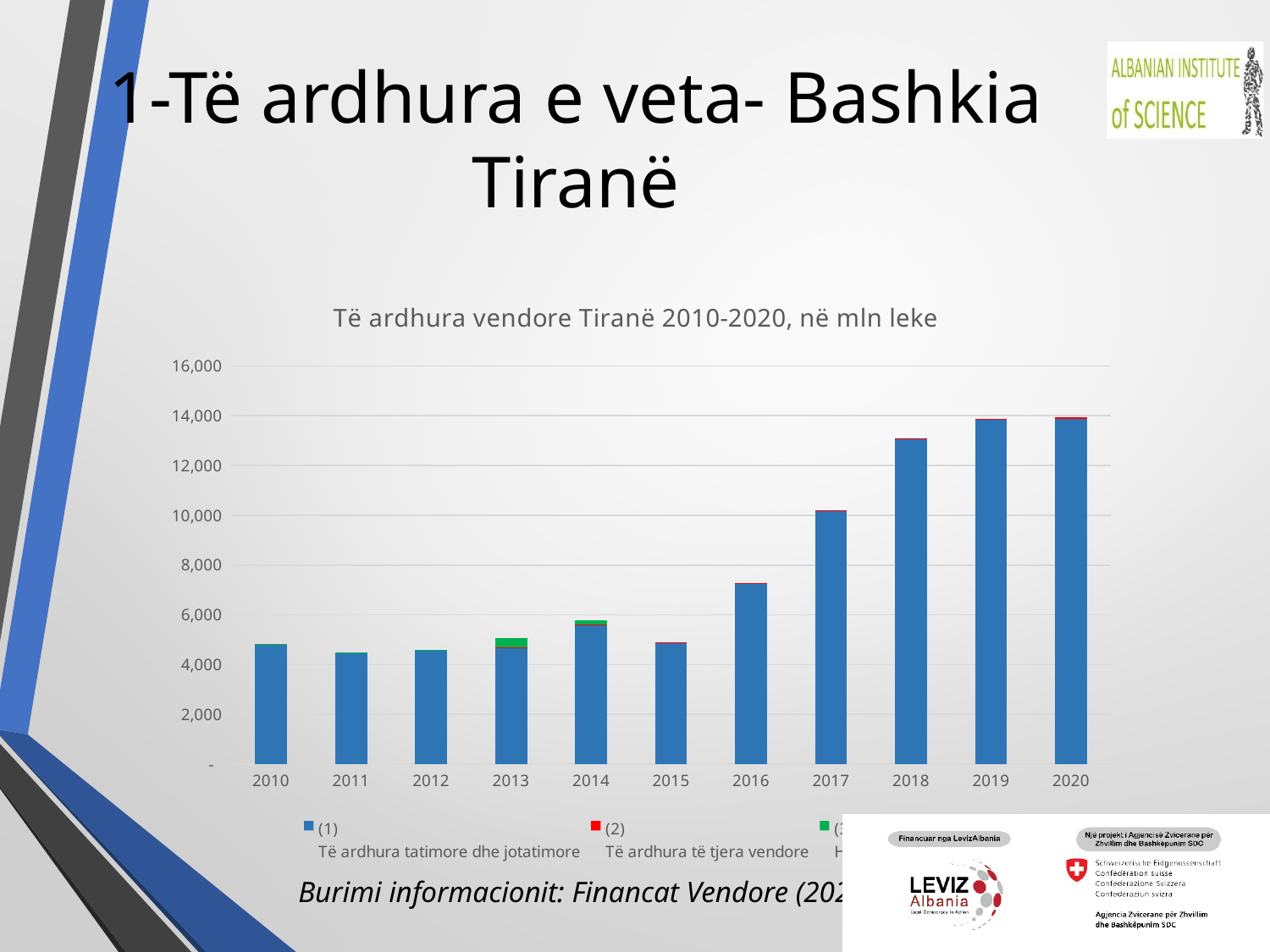
What kind of chart is shown on the slide? bar chart Which year has the larger total value, 2017 or 2018? 2018 Which year has the larger total value, 2015 or 2016? 2016 Is the total value for 2016 greater or less than 8,000? less How many series does the chart's legend list? 3 How many years are shown on the x axis of the chart? 11 Is the total value for 2010 greater or less than 4,000? greater Is the total value for 2015 greater or less than 6,000? less What is the title of the chart? Të ardhura vendore Tiranë 2010-2020, në mln leke Do the total values generally rise or fall from 2015 to 2020? rise What is the legend label of series (1), shown in blue? Të ardhura tatimore dhe jotatimore